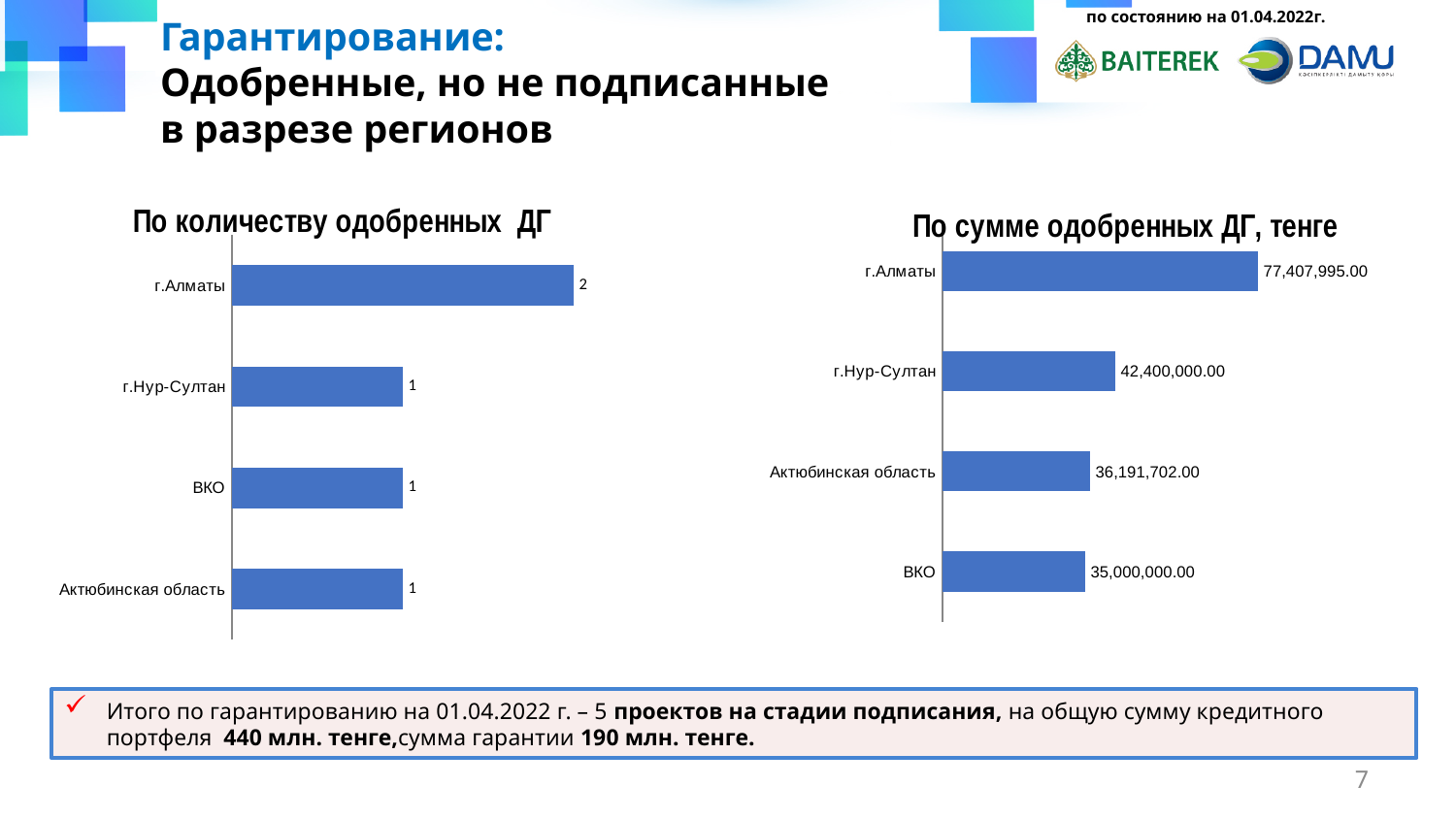
In the chart 'По сумме одобренных ДГ, тенге', what is the difference between г.Алматы and г.Нур-Султан? 35,007,995.00 In the chart 'По количеству одобренных ДГ', which category has the highest value? г.Алматы In the chart 'По сумме одобренных ДГ, тенге', what is the value for Актюбинская область? 36,191,702.00 What is the title of the right-hand chart on the slide? По сумме одобренных ДГ, тенге In the chart 'По сумме одобренных ДГ, тенге', what is the value for г.Нур-Султан? 42,400,000.00 In the chart 'По сумме одобренных ДГ, тенге', which category has the highest value? г.Алматы In the chart 'По количеству одобренных ДГ', what is the value for г.Алматы? 2 How many categories are shown in the chart 'По количеству одобренных ДГ'? 4 What type of chart is 'По количеству одобренных ДГ'? Bar chart In the chart 'По сумме одобренных ДГ, тенге', which category has the lowest value? ВКО In the chart 'По количеству одобренных ДГ', what is the difference between г.Алматы and ВКО? 1 In the chart 'По сумме одобренных ДГ, тенге', which is larger: Актюбинская область or ВКО? Актюбинская область